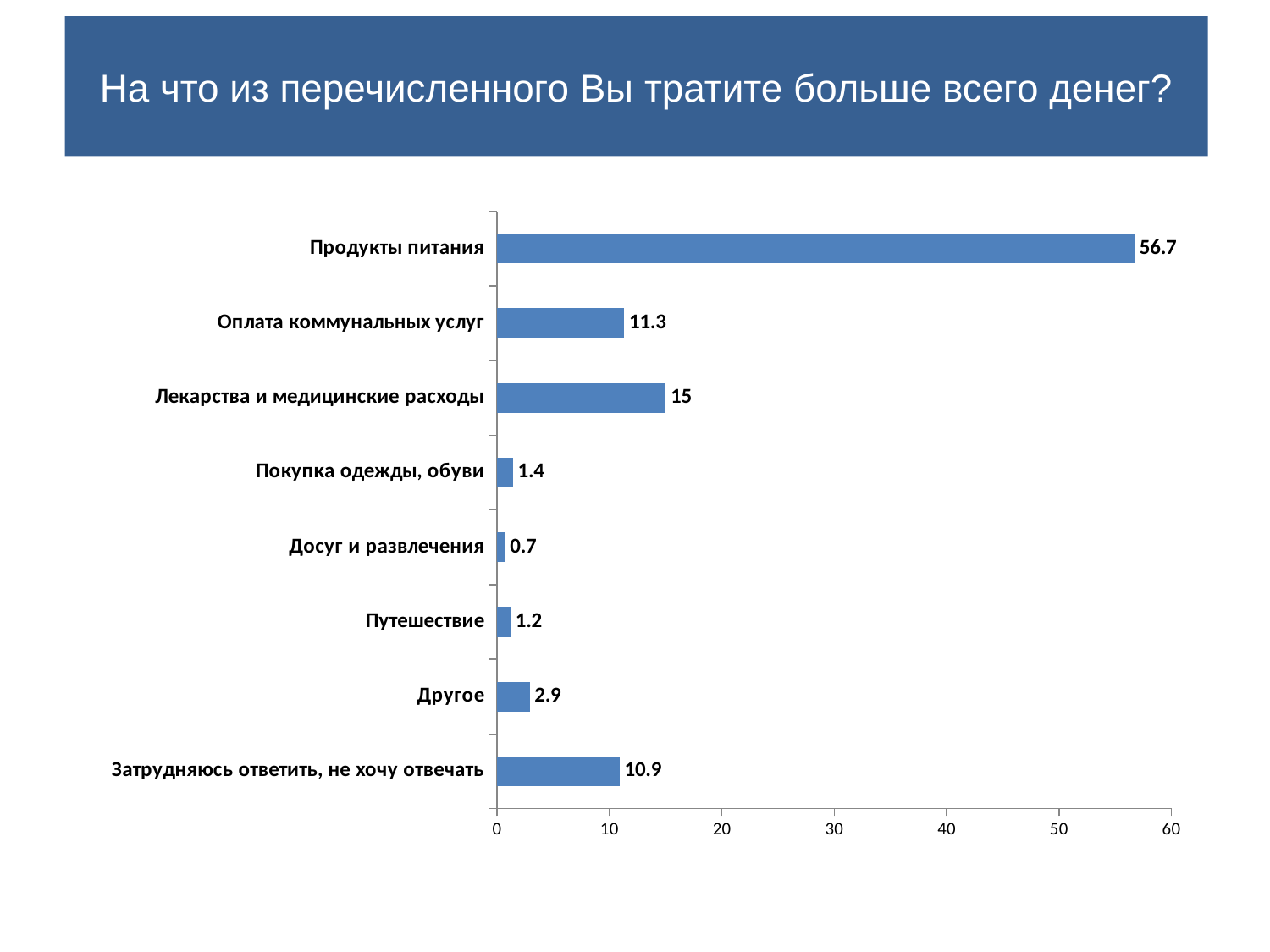
What is the difference between the values for Лекарства и медицинские расходы and Оплата коммунальных услуг? 3.7 Which category has the highest value? Продукты питания What is the maximum value shown on the horizontal axis? 60 What is the value for Затрудняюсь ответить, не хочу отвечать? 10.9 What is the value for Лекарства и медицинские расходы? 15 Is the value for Продукты питания greater or less than 50? greater What kind of chart is shown on the slide? bar chart How many categories are shown in the chart? 8 What is the value for Продукты питания? 56.7 Which category has the lowest value? Досуг и развлечения Which is larger, the value for Другое or the value for Путешествие? Другое What is the title of the slide? На что из перечисленного Вы тратите больше всего денег?